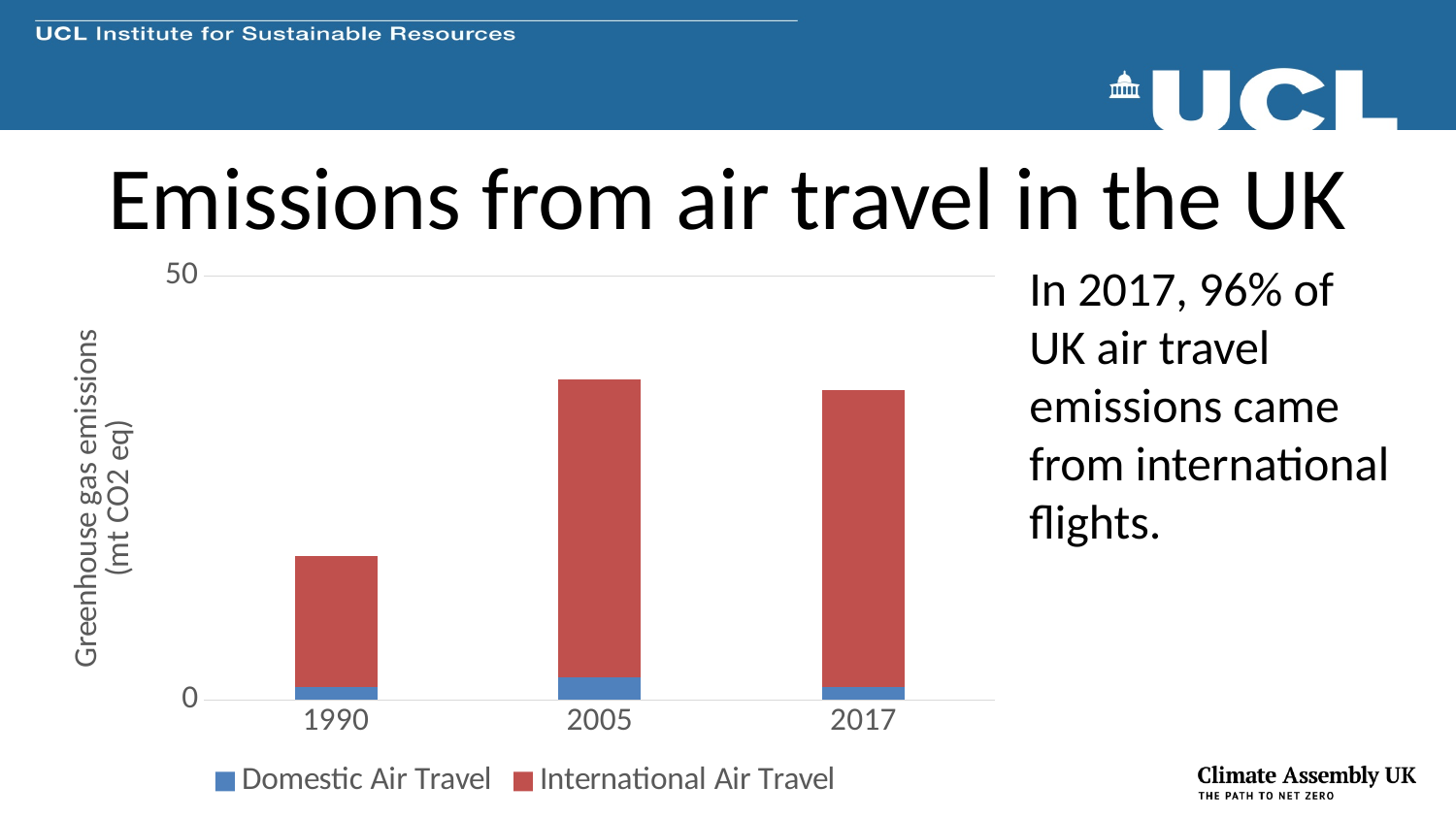
What kind of chart is shown on the slide? Stacked bar chart Which year has larger total air travel emissions, 1990 or 2017? 2017 Which year has the largest Domestic Air Travel segment in the chart? 2005 Which year has the lowest total air travel emissions in the chart? 1990 Is the total air travel emissions for 2005 greater or less than 50 mt CO2 eq? less What colour represents International Air Travel in the chart? Red How many years are shown on the x axis of the chart? 3 Do total air travel emissions rise or fall from 1990 to 2005? rise How many series does the chart's legend list? 2 What is the title of the chart on the slide? Emissions from air travel in the UK Is the total air travel emissions for 1990 greater or less than 50 mt CO2 eq? less Which year has the highest total air travel emissions in the chart? 2005